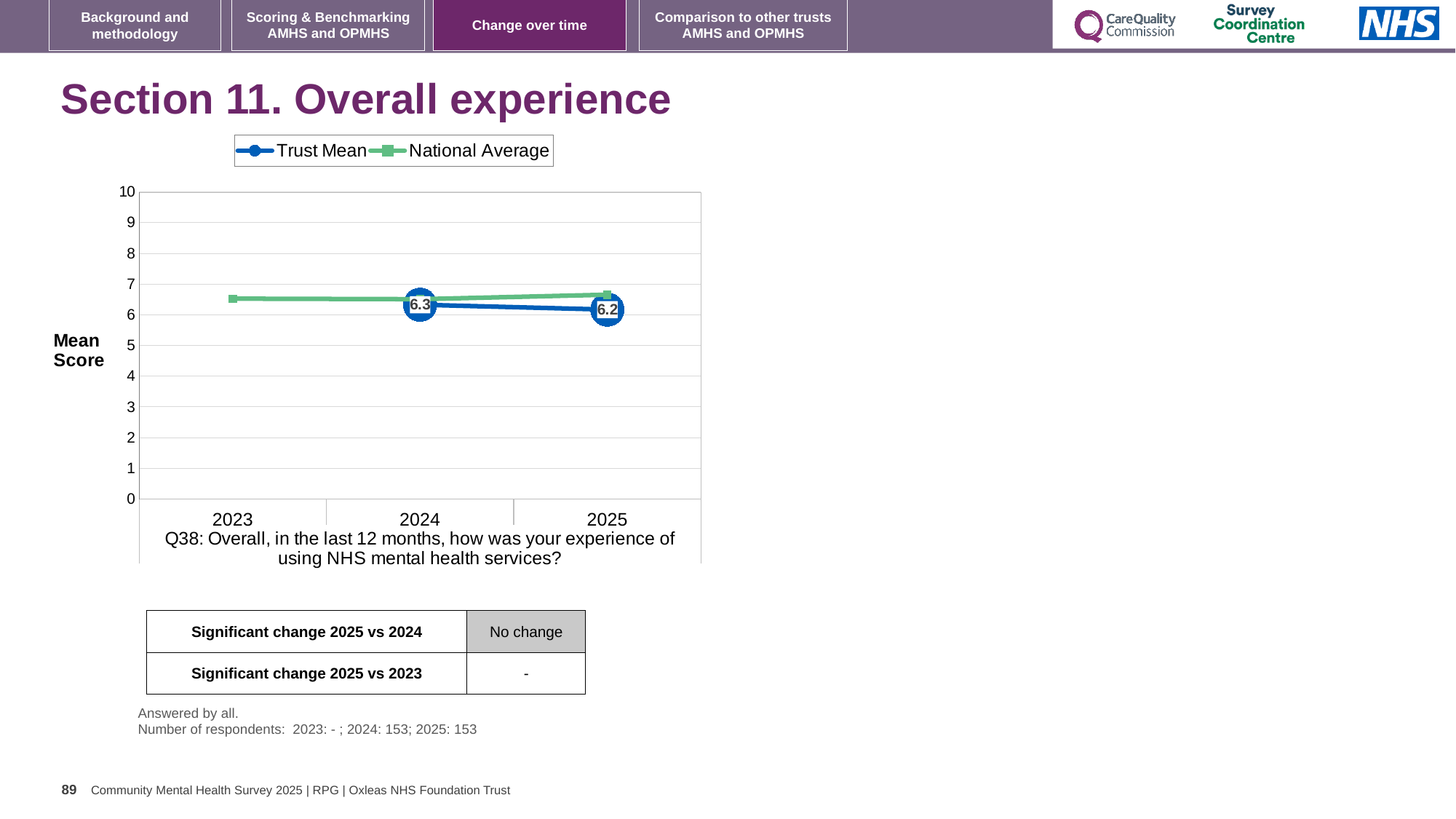
What are the two series named in the legend? Trust Mean and National Average What is the Trust Mean value for 2024? 6.3 Is the National Average value for 2025 greater or less than 8? less By how much did the Trust Mean change from 2024 to 2025? decreased by 0.1 Which year has the higher Trust Mean, 2024 or 2025? 2024 What is the label on the y axis? Mean Score How many years are shown on the x axis? 3 Is the National Average value for 2023 greater or less than 5? greater What kind of chart is shown on the slide? line chart What is the Trust Mean value for 2025? 6.2 How many series does the legend list? 2 Does the Trust Mean rise or fall from 2024 to 2025? fall